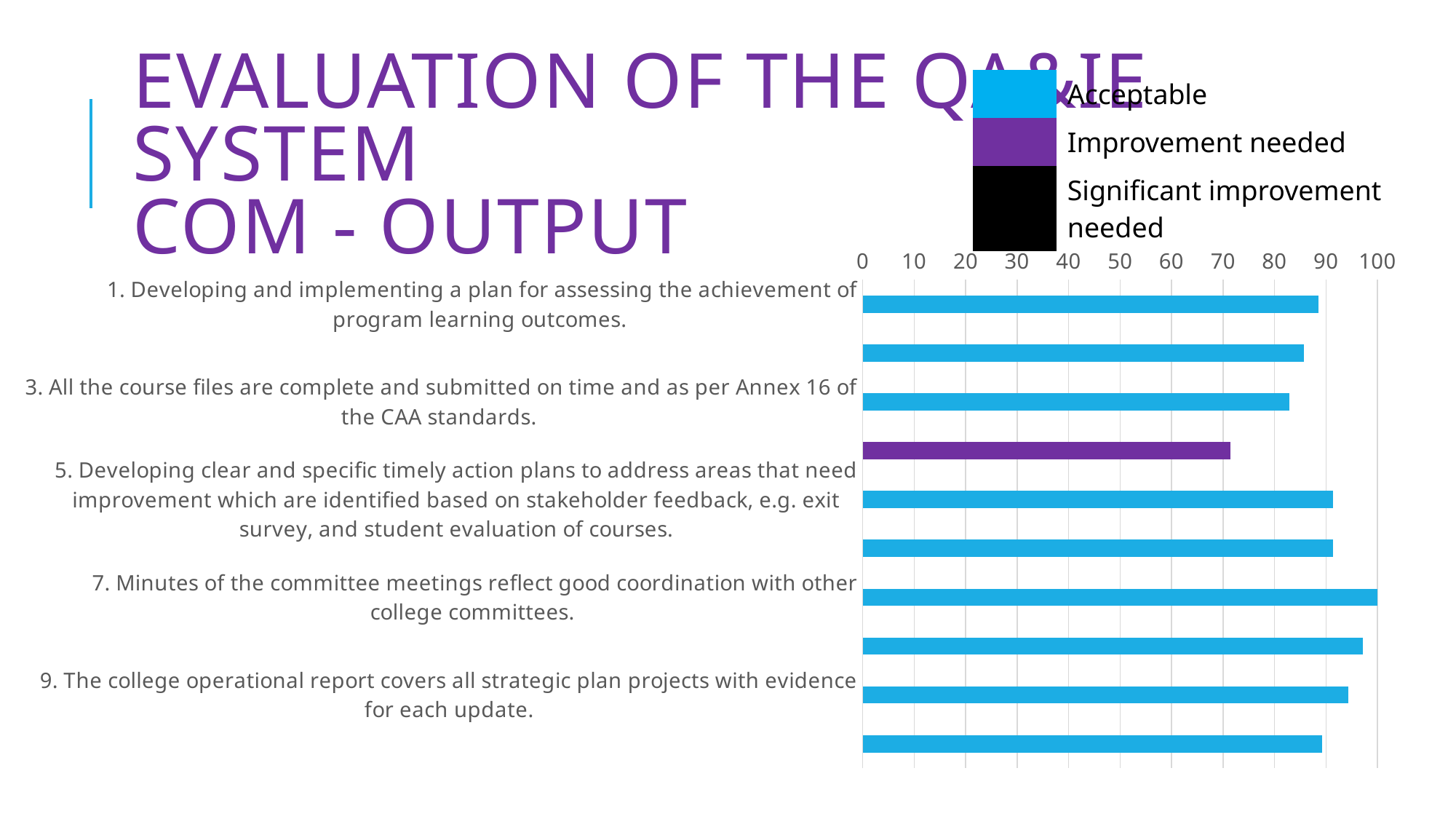
How many entries does the legend list? 3 Is the value of the purple bar greater or less than 80? less Is the value for item 1 (Developing and implementing a plan for assessing the achievement of program learning outcomes) greater or less than 80? greater Which item has the highest value in the chart? 7. Minutes of the committee meetings reflect good coordination with other college committees. According to the legend, what colour represents 'Improvement needed'? purple What value does the bar for item 7 (Minutes of the committee meetings reflect good coordination with other college committees) reach? 100 Which has the larger value: item 7 (Minutes of the committee meetings) or item 3 (All the course files are complete)? item 7 What kind of chart is shown on the slide? bar chart Is the value for item 9 (The college operational report covers all strategic plan projects) greater or less than 90? greater Which has the larger value: item 9 (The college operational report) or item 1 (Developing and implementing a plan for assessing program learning outcomes)? item 9 How many bars are plotted in the chart? 10